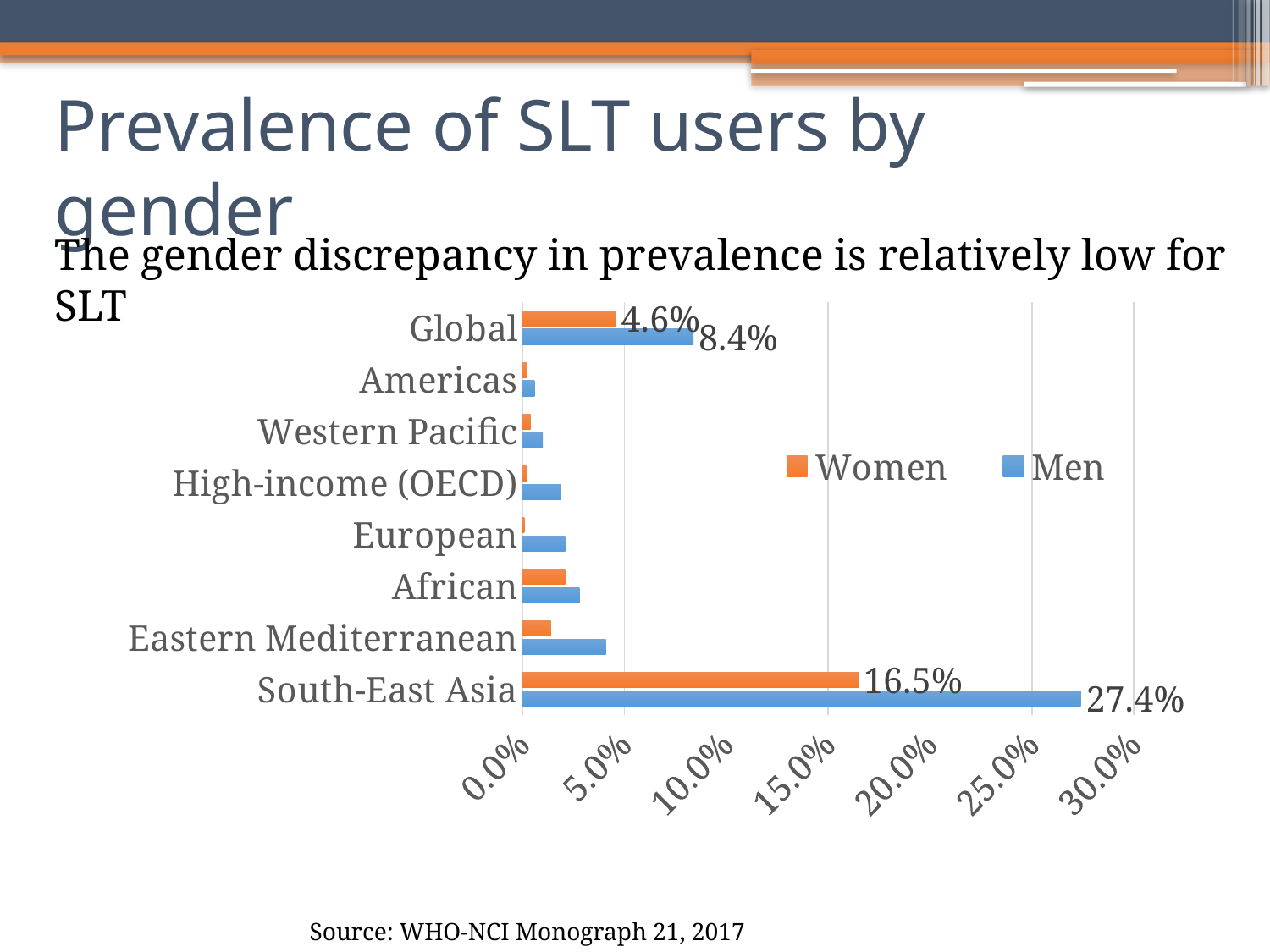
What is the difference between the Men and Women values in the Global category? 3.8% Is the value for Men in Eastern Mediterranean greater or less than 5.0%? less What is the value for Women in South-East Asia? 16.5% Which category has the highest value for Men? South-East Asia How many series does the legend list? 2 How many categories are shown on the chart? 8 Is the value for Men in South-East Asia greater or less than 25.0%? greater What is the value for Men in the Global category? 8.4% What is the value for Men in South-East Asia? 27.4% What kind of chart is shown on the slide? Bar chart What is the difference between the Men and Women values for South-East Asia? 10.9% What is the value for Women in the Global category? 4.6%